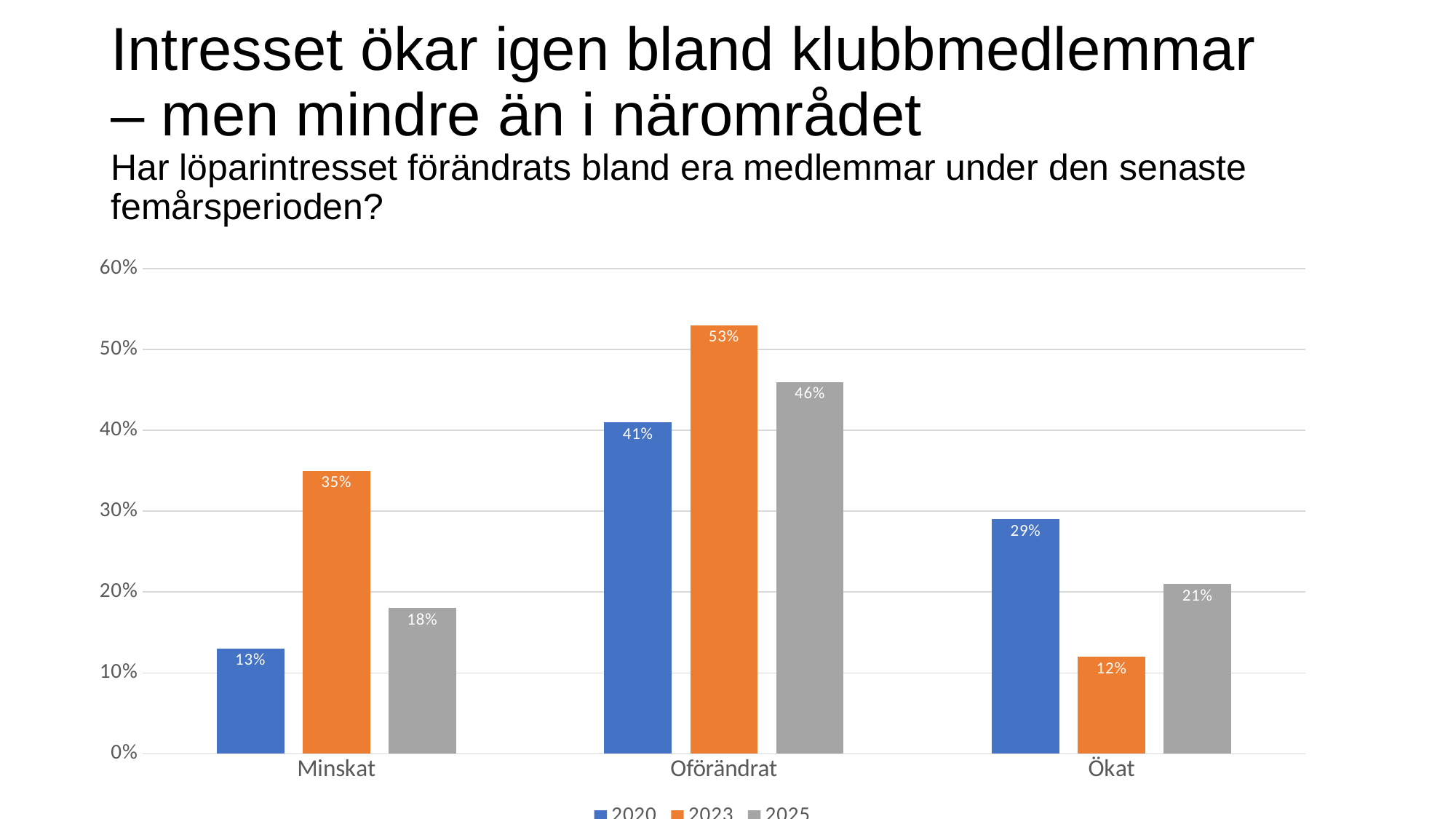
What is the difference between the 2023 and 2020 values in the Minskat category? 22% What is the value for 2020 in the Oförändrat category? 41% Is the value for 2023 in the Oförändrat category greater or less than 50%? greater Which series has the highest value in the Oförändrat category? 2023 Which is larger in the Oförändrat category, the 2025 value or the 2020 value? 2025 How many categories are shown on the x axis? 3 What kind of chart is shown on the slide? bar chart What is the difference between the 2020 and 2025 values in the Ökat category? 8% How many series does the legend list? 3 Which series has the lowest value in the Ökat category? 2023 What is the value for 2025 in the Ökat category? 21% What is the value for 2023 in the Minskat category? 35%